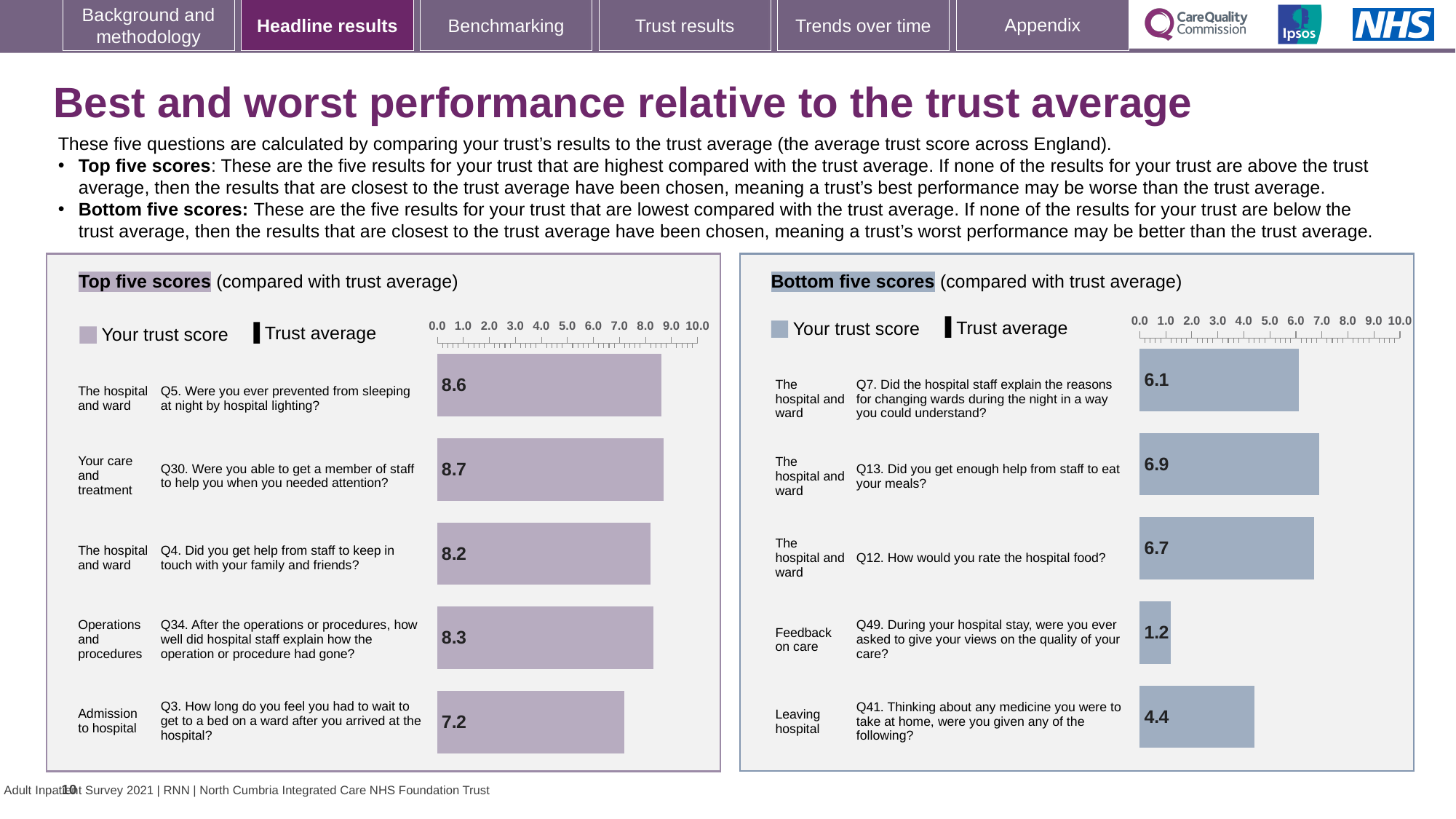
In the Bottom five scores chart, what is the trust score for Q49 (being asked to give your views on the quality of your care)? 1.2 In the Top five scores chart, which question has the highest trust score? Q30 In the Top five scores chart, what is the difference between the scores for Q5 and Q3? 1.4 In the Top five scores chart, which has the larger score: Q4 or Q34? Q34 In the Bottom five scores chart, what is the difference between the scores for Q41 and Q49? 3.2 What kind of chart is the Top five scores chart? Bar chart In the Top five scores chart, what is the trust score for Q30 (getting a member of staff to help when you needed attention)? 8.7 In the Bottom five scores chart, which question has the lowest trust score? Q49 In the Bottom five scores chart, which question has the highest trust score? Q13 How many questions are plotted in the Bottom five scores chart? 5 In the Bottom five scores chart, what is the trust score for Q12 (how would you rate the hospital food)? 6.7 In the Top five scores chart, what is the trust score for Q3 (how long you had to wait to get to a bed on a ward)? 7.2